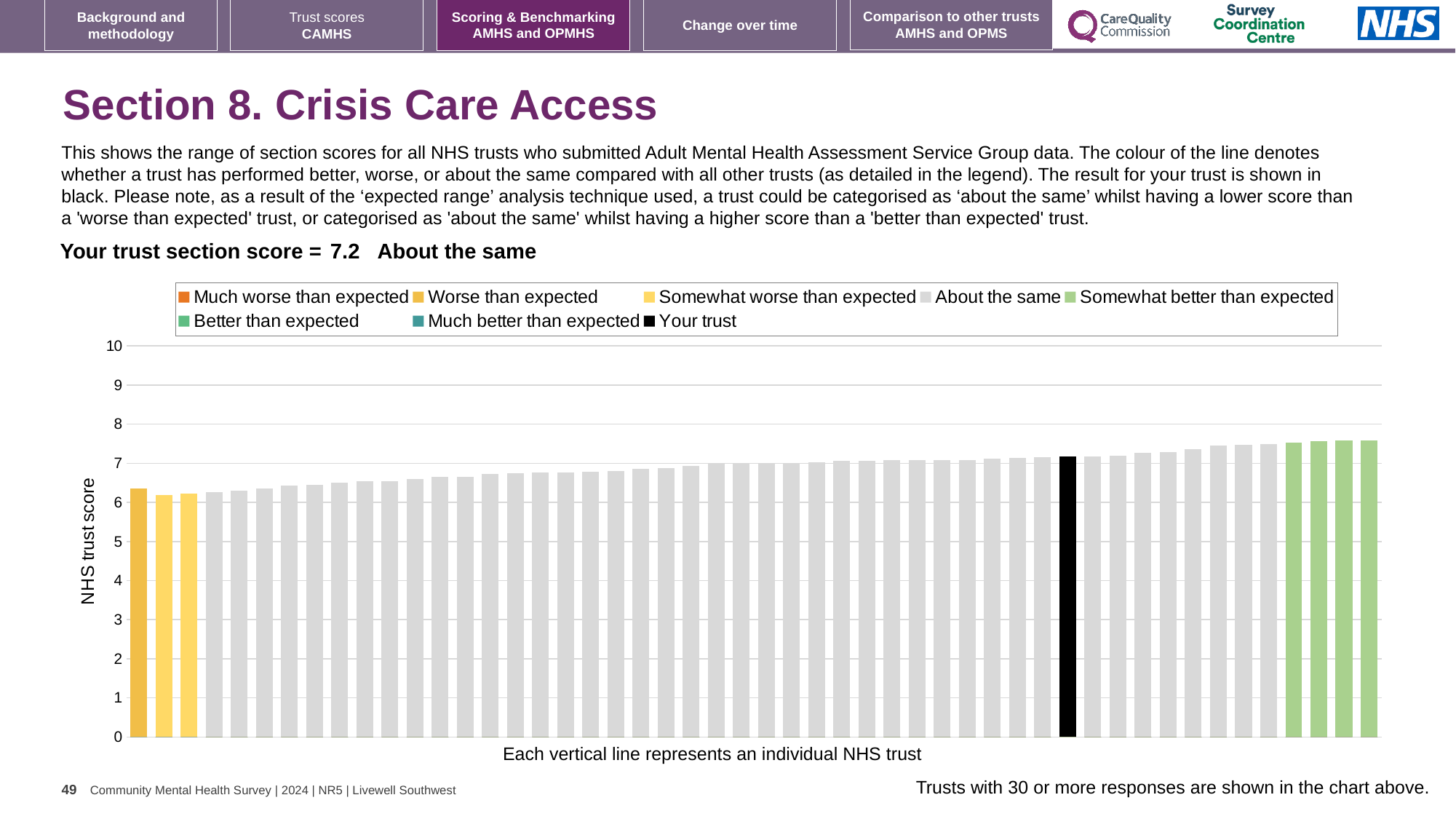
What kind of chart is shown on the slide? Bar chart Is the value of the leftmost bar greater or less than 7? less How many entries does the chart legend list? 8 Do the bar values rise or fall from left to right across the chart? Rise Which is higher, the black 'Your trust' bar or the leftmost bar? The black 'Your trust' bar What is the section score for your trust shown on the slide? 7.2 What colour is the bar representing your trust in the chart? Black How many green bars are shown at the right end of the chart? 4 Is the value of the black 'Your trust' bar greater or less than 8? less Is the value of the rightmost bar greater or less than 8? less What is the label on the vertical axis of the chart? NHS trust score